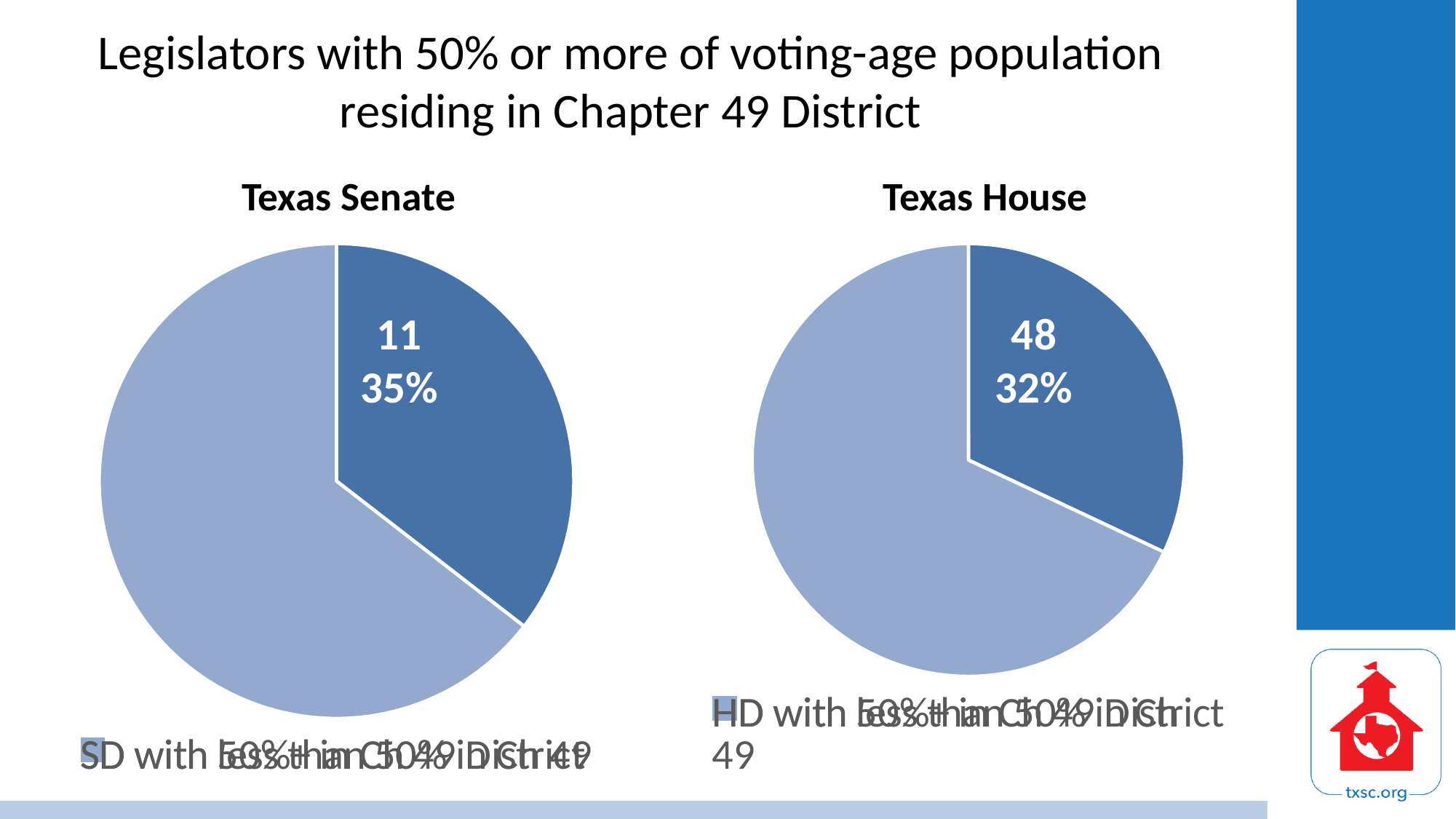
How many slices does the Texas House pie chart have? 2 In the Texas Senate chart, which slice is larger, the dark blue slice or the light blue slice? The light blue slice What is the title of the chart on the right side of the slide? Texas House What is the overall title of the slide above the two charts? Legislators with 50% or more of voting-age population residing in Chapter 49 District In the Texas House chart, what count is printed on the dark blue slice? 48 What is the difference in percentage points between the labeled slice in the Texas Senate chart and the labeled slice in the Texas House chart? 3 percentage points What is the difference between the count labeled in the Texas House chart and the count labeled in the Texas Senate chart? 37 In the Texas Senate chart, what percentage is printed on the dark blue slice? 35% In the Texas Senate chart, what count is printed on the dark blue slice? 11 Which chart shows a larger labeled percentage for its dark blue slice, Texas Senate or Texas House? Texas Senate In the Texas House chart, what percentage is printed on the dark blue slice? 32% What kind of chart is the Texas Senate chart? Pie chart